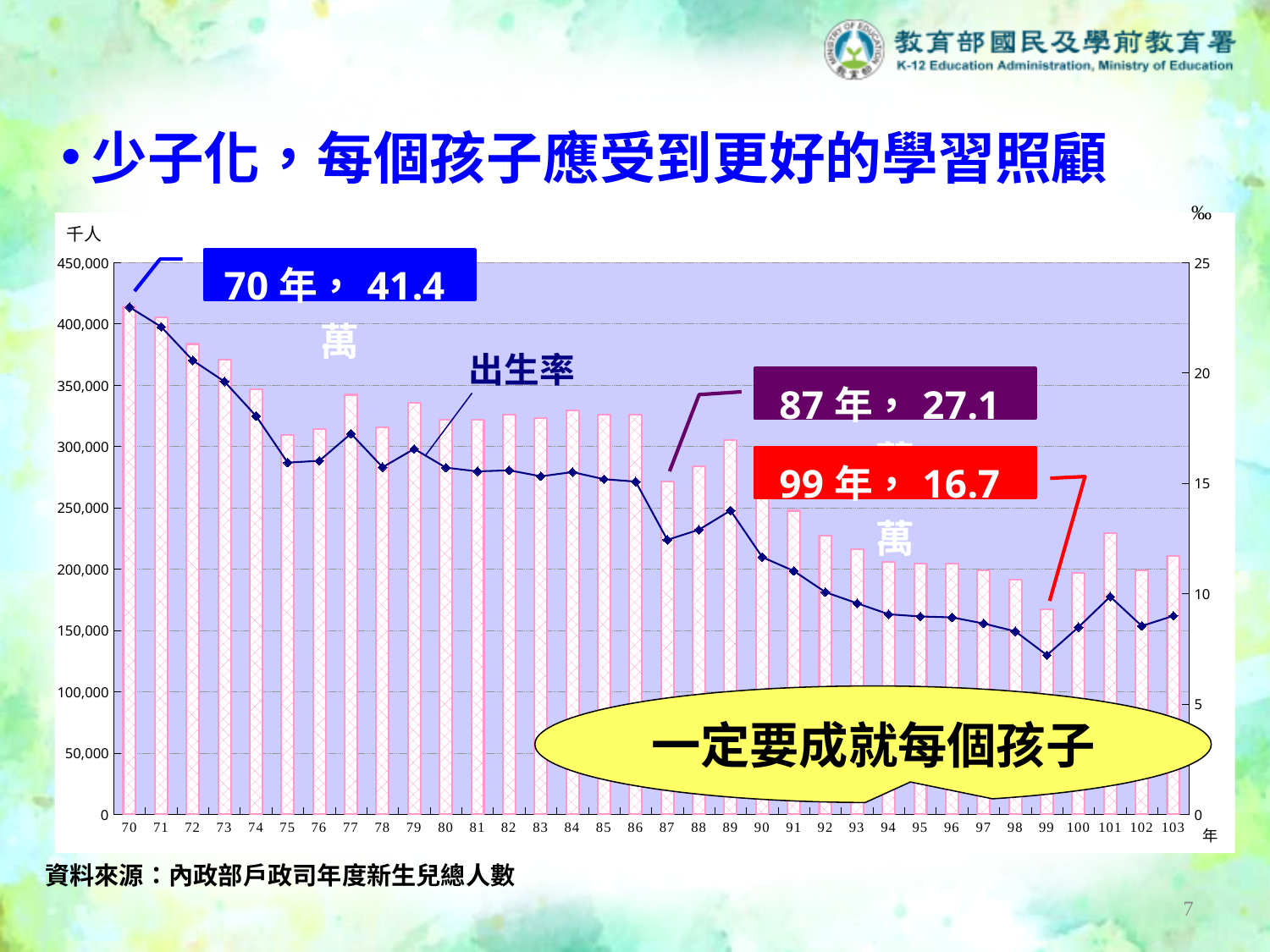
Which year has the tallest bar in the chart? 70 What is the difference between the callout values for year 70 and year 99? 24.7萬 According to the callout on the chart, what is the value for year 99? 16.7萬 According to the callout on the chart, what is the value for year 87? 27.1萬 How many years (categories) are shown along the x axis of the chart? 34 Is the bar value for year 70 greater or less than 400,000? greater Is the bar value for year 103 greater or less than 250,000? less What kind of chart is shown on the slide? A combined bar and line chart Which year has the shortest bar in the chart? 99 According to the callout on the chart, what is the value for year 70? 41.4萬 What is the label given to the line series in the chart? 出生率 Which bar is taller, year 100 or year 101? 101